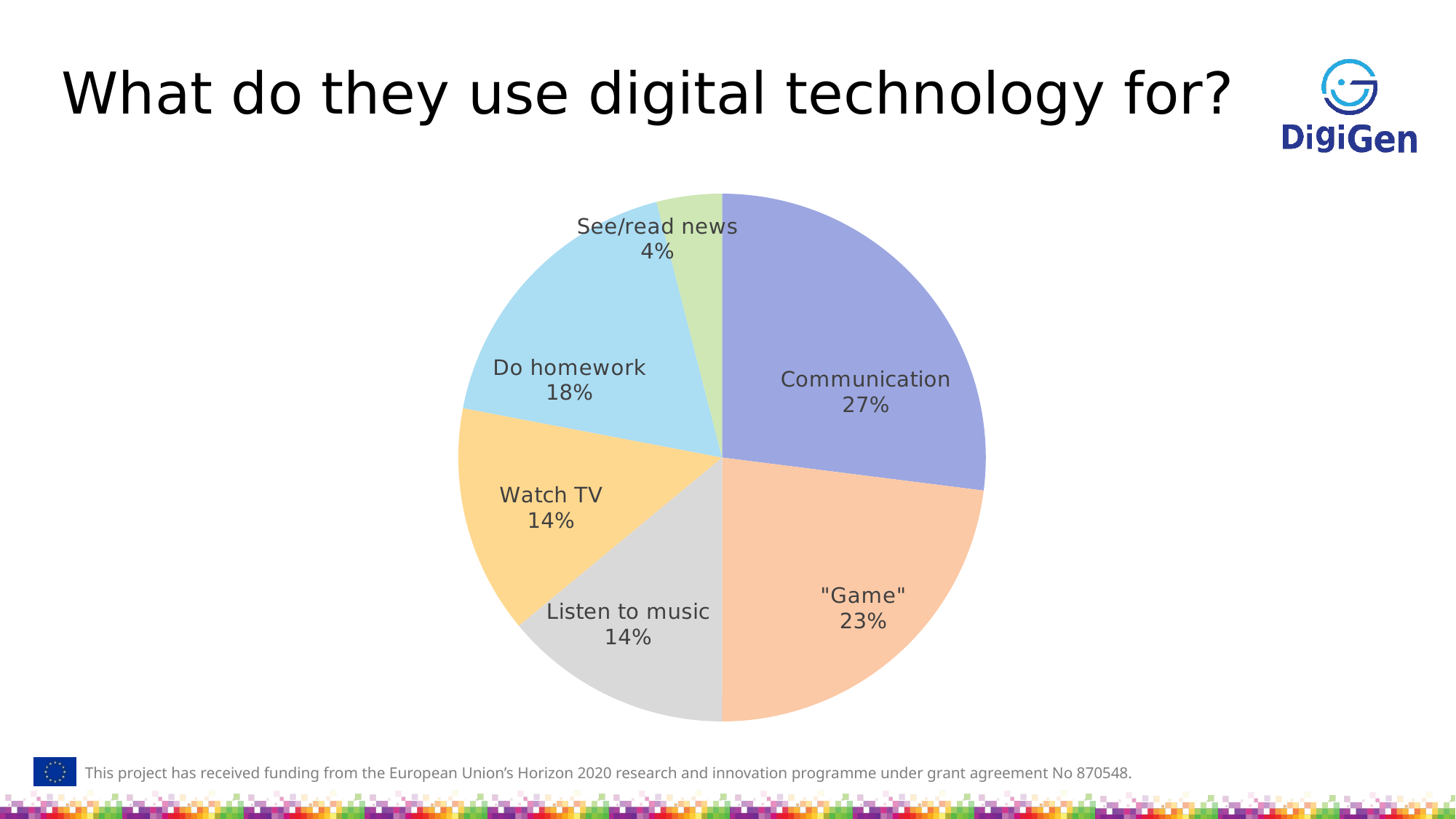
What type of chart is shown on the slide? pie chart What is the value shown for "Game"? 23% What is the difference between the Do homework and See/read news shares? 14% Which category has the largest slice of the pie? Communication What share of the pie does Communication have? 27% Which category has the smallest slice of the pie? See/read news What is the value shown for See/read news? 4% What is the difference between the Communication and "Game" shares? 4% What is the title of the slide containing the chart? What do they use digital technology for? How many categories are shown in the pie chart? 6 What is the value shown for Do homework? 18% Which is larger, Do homework or Watch TV? Do homework